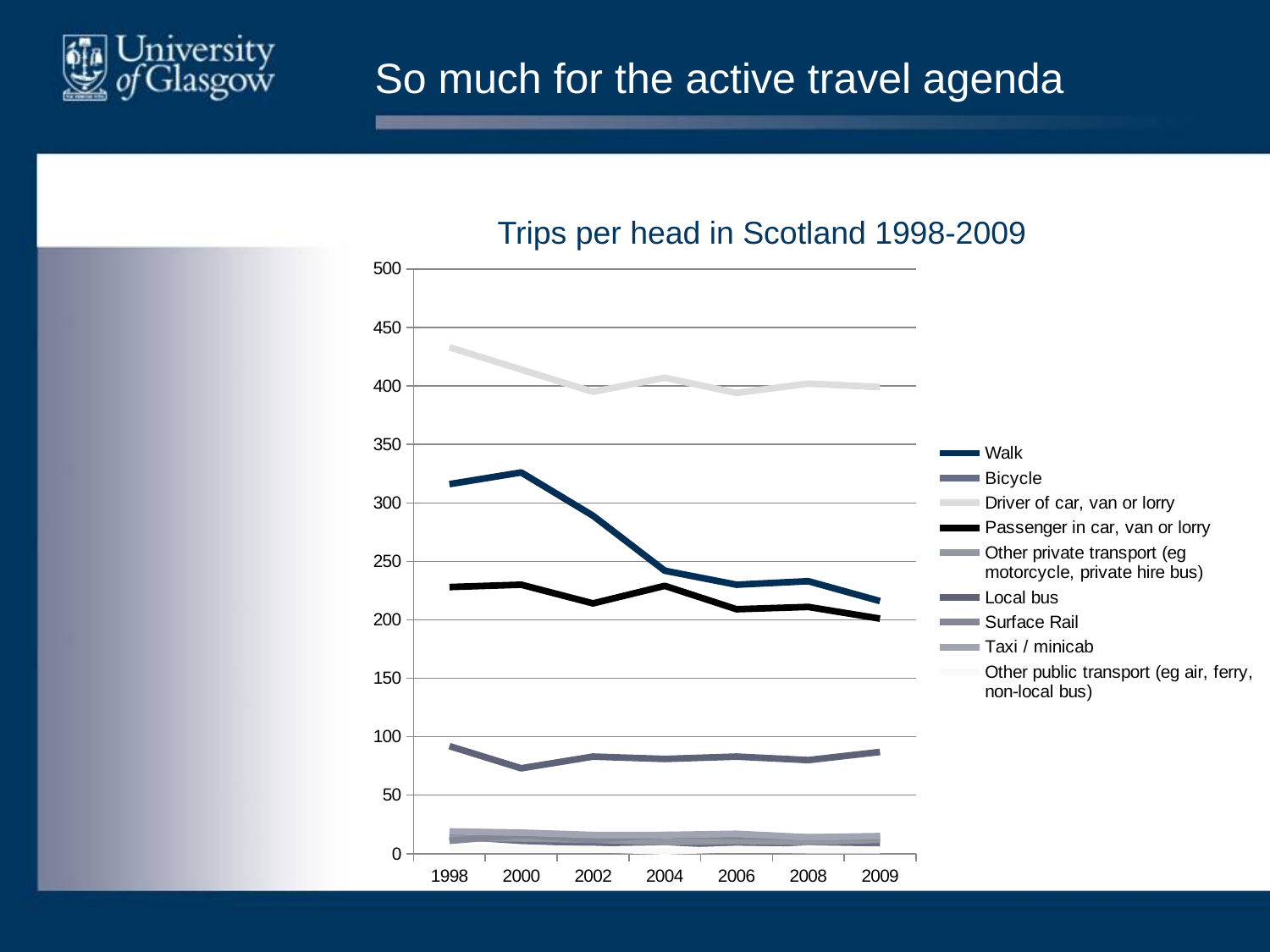
Which series has the highest values across the whole period? Driver of car, van or lorry What is the title of the chart? Trips per head in Scotland 1998-2009 Is the value for Local bus in 2000 greater or less than 100? less Is the value for Passenger in car, van or lorry in 2009 greater or less than 250? less In 2000, which is larger: Walk or Passenger in car, van or lorry? Walk What kind of chart is shown on the slide? line chart Is the value for Walk in 2009 greater or less than 250? less How many series does the legend list? 9 How many years are labelled on the x axis? 7 Does the Walk series rise or fall between 1998 and 2009? fall